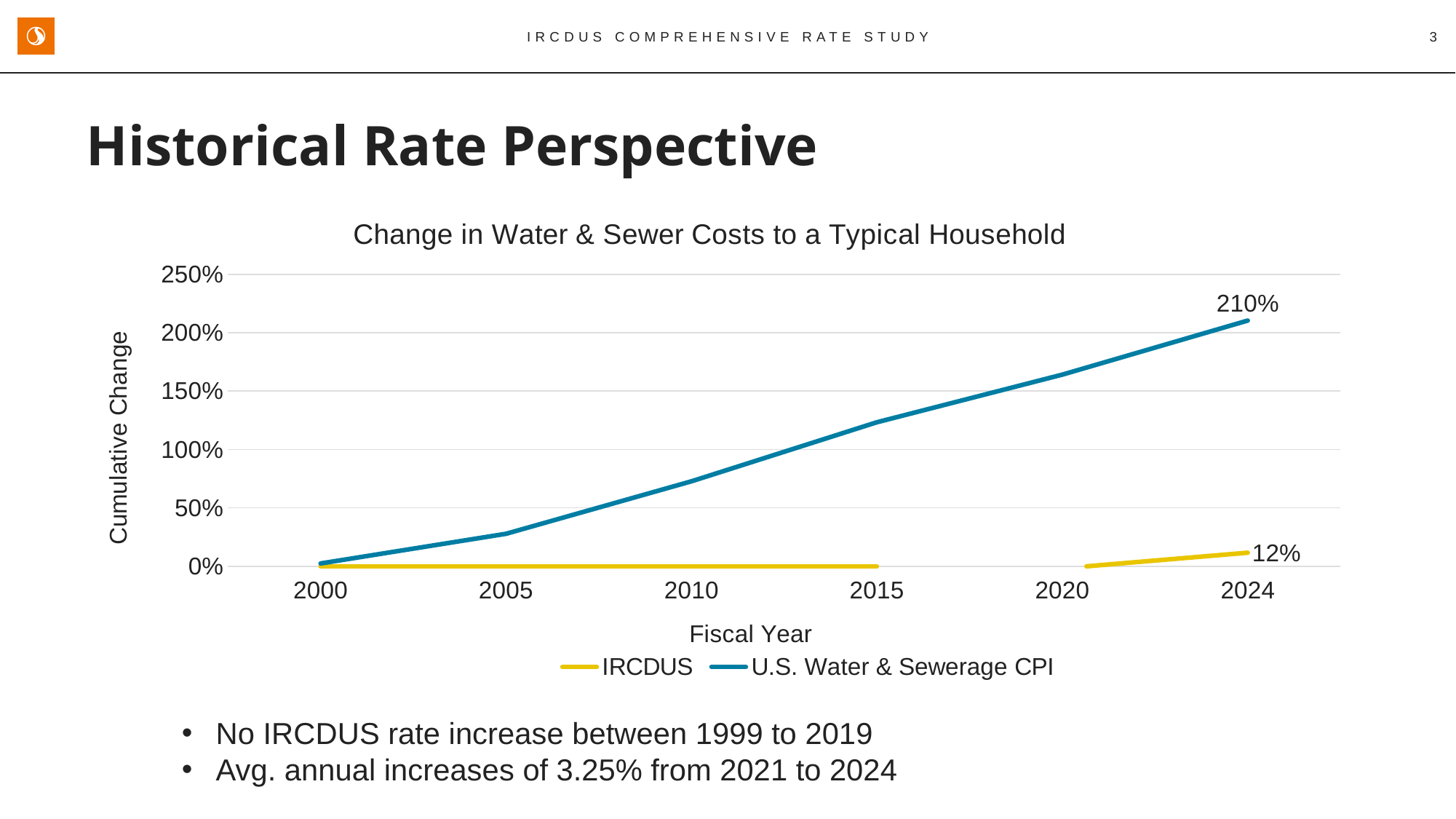
What is the title of the chart? Change in Water & Sewer Costs to a Typical Household Which series has the higher value in 2024, IRCDUS or U.S. Water & Sewerage CPI? U.S. Water & Sewerage CPI What is the cumulative change for IRCDUS in 2024? 12% Is the value for U.S. Water & Sewerage CPI in 2020 greater or less than 150%? greater How many series does the legend list? 2 What kind of chart is shown on the slide? Line chart Is the value for U.S. Water & Sewerage CPI in 2005 greater or less than 50%? less Does the U.S. Water & Sewerage CPI line rise or fall from 2000 to 2024? Rise What is the label of the y axis? Cumulative Change What is the difference between the 2024 values for U.S. Water & Sewerage CPI and IRCDUS? 198% What is the cumulative change for U.S. Water & Sewerage CPI in 2024? 210% Is the value for U.S. Water & Sewerage CPI in 2015 greater or less than 100%? greater